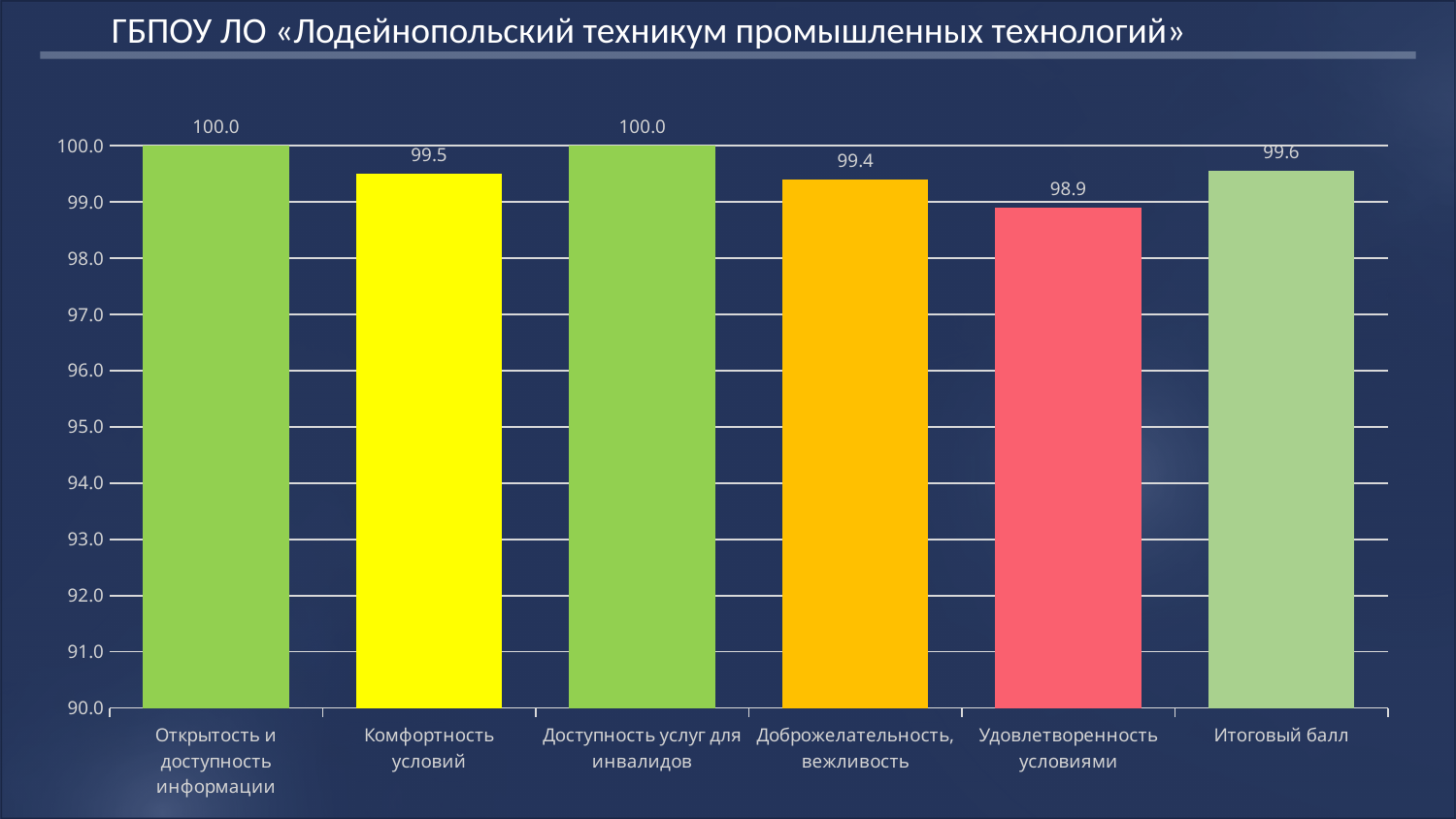
What is the value for «Комфортность условий»? 99.5 Is the value for «Удовлетворенность условиями» greater or less than 99.0? less What colour is the bar for «Удовлетворенность условиями»? red Which category has the lowest value? Удовлетворенность условиями What is the value for «Удовлетворенность условиями»? 98.9 How many categories are shown on the x axis? 6 What kind of chart is shown on the slide? bar chart What is the value for «Доброжелательность, вежливость»? 99.4 What is the difference between the values for «Итоговый балл» and «Доброжелательность, вежливость»? 0.2 What is the difference between the values for «Открытость и доступность информации» and «Удовлетворенность условиями»? 1.1 Which is larger, the value for «Комфортность условий» or the value for «Удовлетворенность условиями»? Комфортность условий What is the value for «Итоговый балл»? 99.6